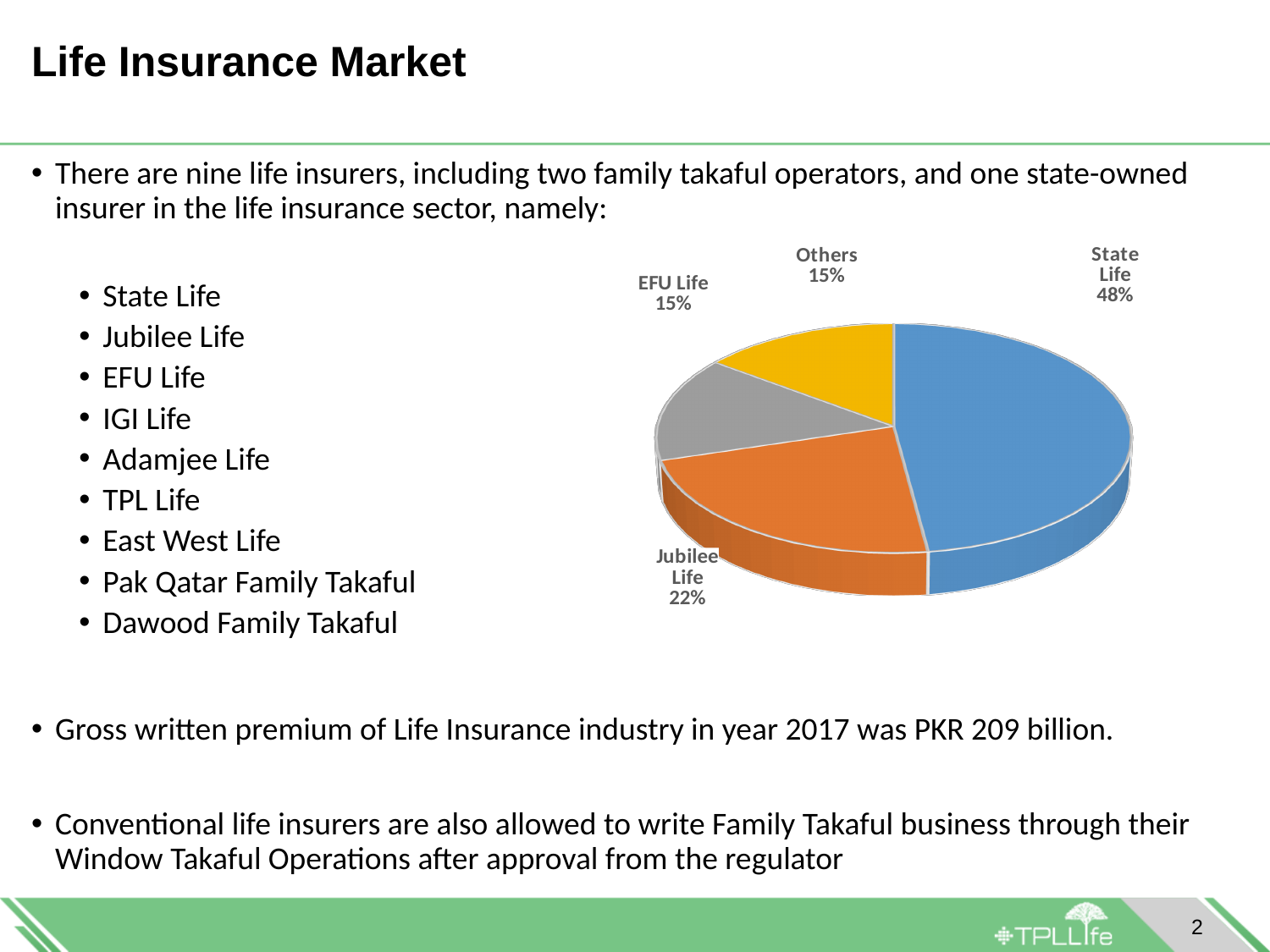
How many slices does the pie chart have? 4 Which slice of the pie chart is the largest? State Life What is the difference in percentage points between the Jubilee Life slice and the EFU Life slice? 7 What share of the pie chart does EFU Life hold? 15% What share of the pie chart does Jubilee Life hold? 22% What colour is the State Life slice in the pie chart? Blue Which is larger in the pie chart, Jubilee Life or EFU Life? Jubilee Life What colour is the Others slice in the pie chart? Yellow What is the difference in percentage points between the State Life slice and the Jubilee Life slice? 26 What share of the pie chart does State Life hold? 48% What kind of chart is shown on the slide? Pie chart What share of the pie chart is labelled Others? 15%